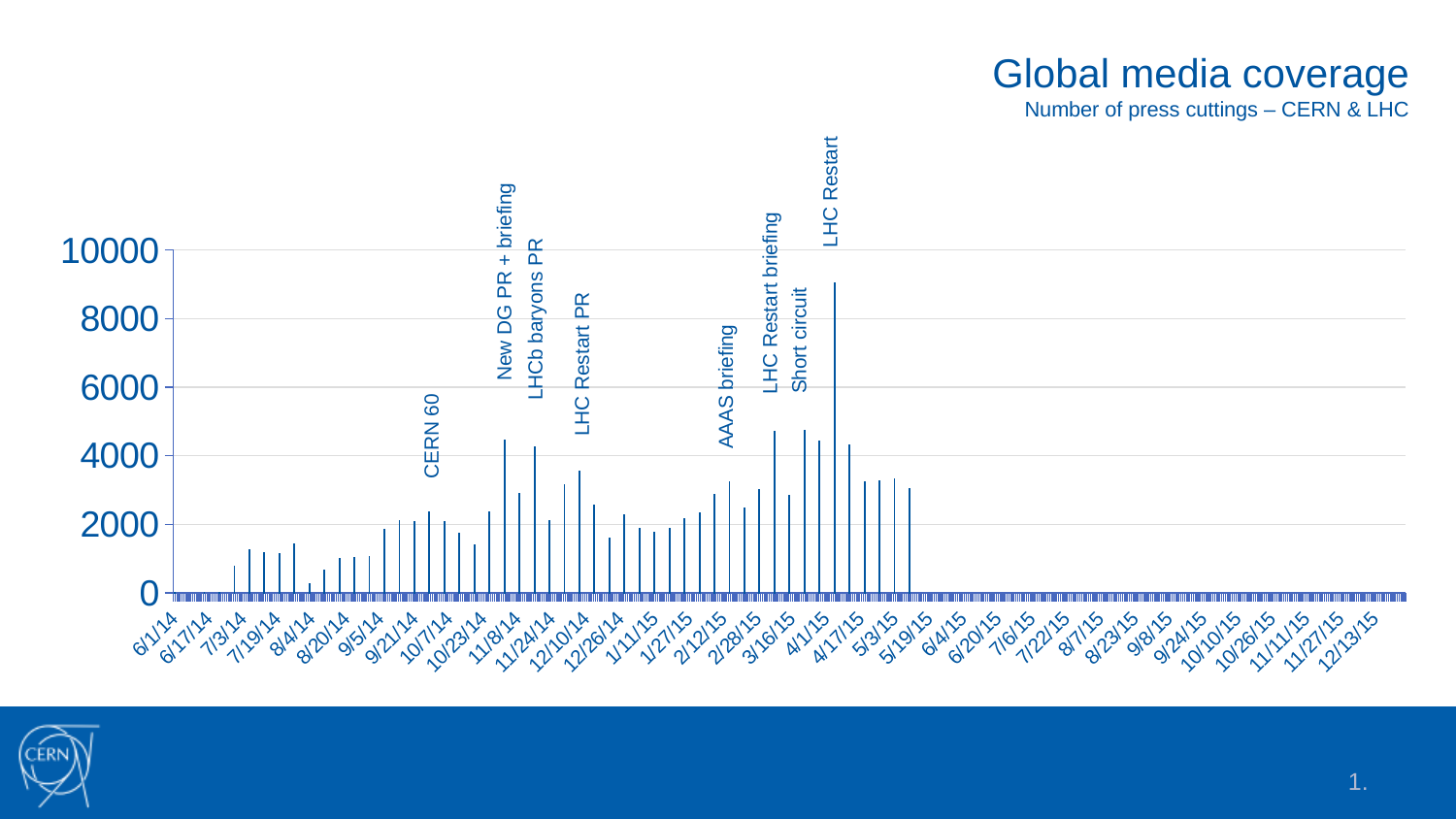
Is the value for the bar labelled LHC Restart PR greater or less than 4000? less Is the value for the bar labelled Short circuit greater or less than 6000? less What kind of chart is shown on the slide? bar chart What does the subtitle say the chart measures? Number of press cuttings – CERN & LHC Which annotated event has the highest bar? LHC Restart Is the value for the bar labelled CERN 60 greater or less than 4000? less Which is larger, the bar labelled LHC Restart or the bar labelled CERN 60? LHC Restart What is the highest value shown on the y axis? 10000 What is the title of the chart? Global media coverage